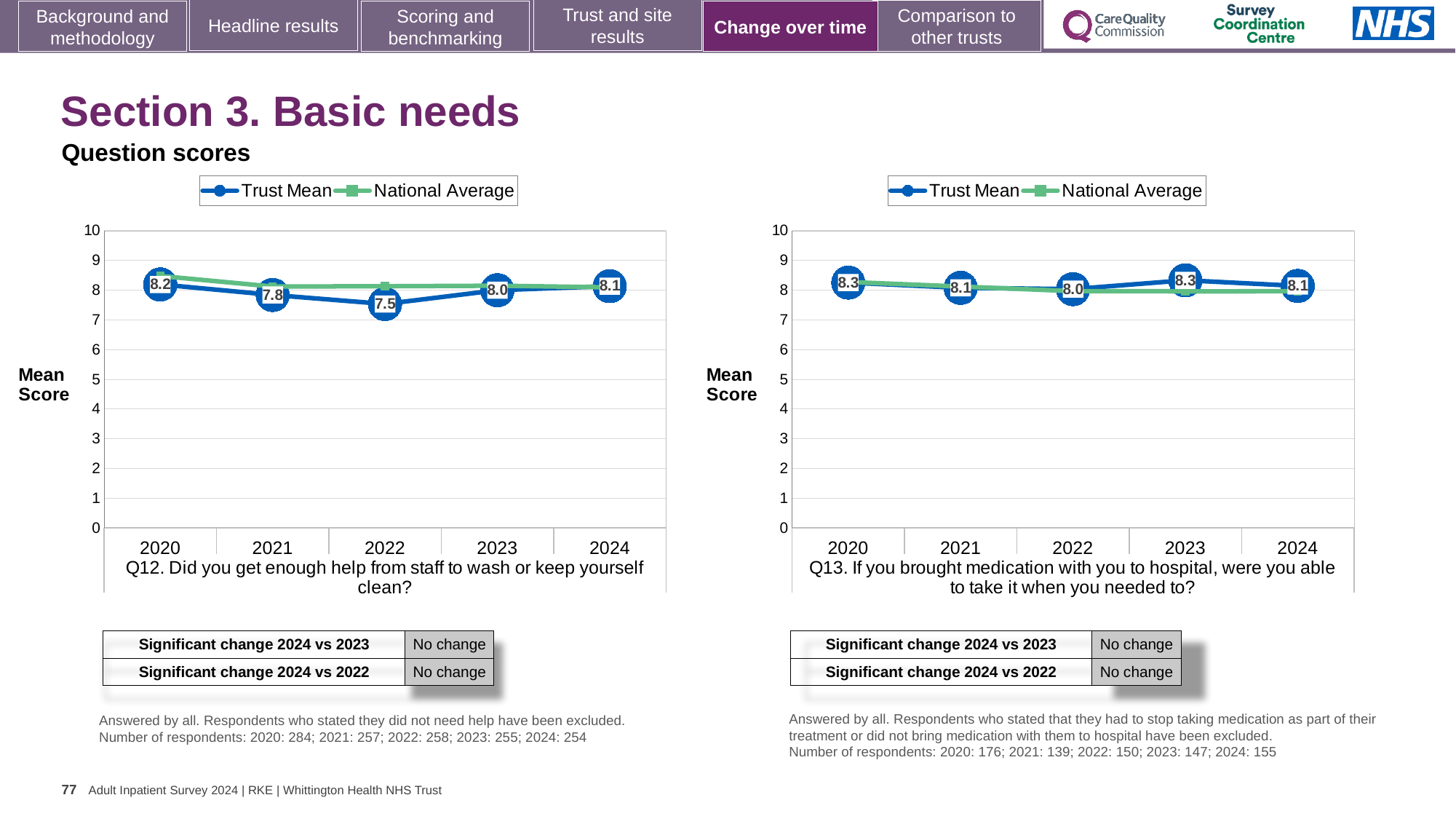
In the Q12 chart, which year has the highest Trust Mean? 2020 What type of chart is used for Q12? Line chart In the Q13 chart, which year has the lowest Trust Mean? 2022 In the Q12 chart, what is the Trust Mean for 2022? 7.5 In the Q13 chart, is the Trust Mean higher in 2023 or in 2024? 2023 In the Q13 chart, what is the Trust Mean for 2020? 8.3 How many series does the legend of the Q13 chart list? 2 In the Q12 chart, what is the difference between the Trust Mean in 2020 and in 2022? 0.7 In the Q12 chart, what is the Trust Mean for 2024? 8.1 In the Q12 chart, is the National Average for 2022 greater or less than 7? greater In the Q12 chart, which year has the lowest Trust Mean? 2022 In the Q13 chart, what is the Trust Mean for 2022? 8.0